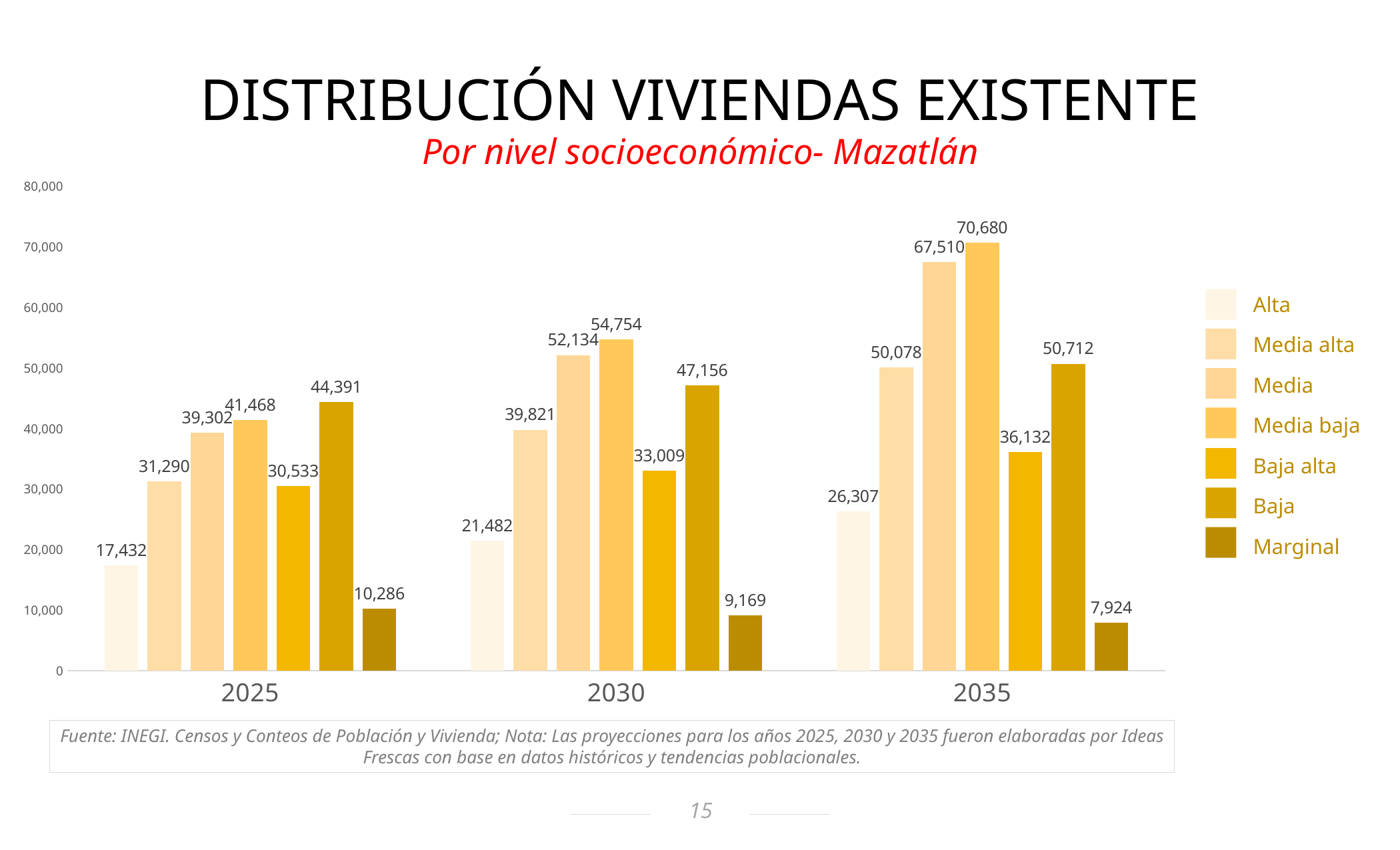
How many series does the legend list? 7 What is the difference between the Media baja and Media values in 2030? 2,620 Which is larger in 2035: Baja or Media alta? Baja Which series has the lowest value in 2030? Marginal Does the value for Marginal rise or fall from 2025 to 2035? Fall What is the value for Alta in 2025? 17,432 What is the value for Media baja in 2035? 70,680 Which series has the highest value in 2025? Baja How many year categories are shown on the x axis? 3 What kind of chart is shown on the slide? Bar chart What is the value for Baja alta in 2030? 33,009 Is the value for Media in 2035 greater or less than 60,000? greater